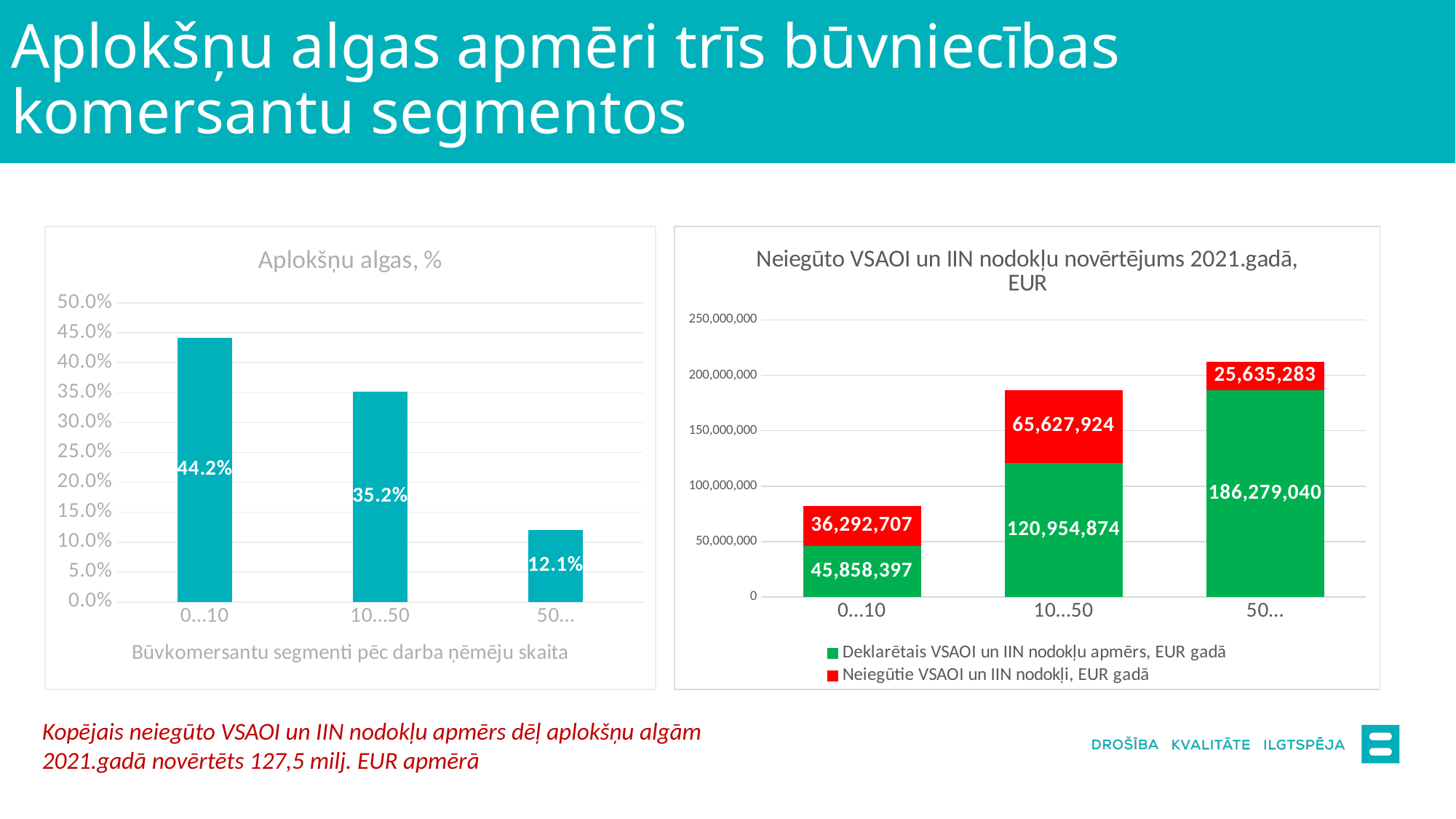
In the chart titled "Neiegūto VSAOI un IIN nodokļu novērtējums 2021.gadā, EUR", which segment has the highest value of "Neiegūtie VSAOI un IIN nodokļi, EUR gadā"? 10...50 In the chart titled "Neiegūto VSAOI un IIN nodokļu novērtējums 2021.gadā, EUR", how many series does the legend list? 2 In the chart titled "Aplokšņu algas, %", how many segments are plotted? 3 What kind of chart is the chart on the right of the slide? Stacked bar chart In the chart titled "Aplokšņu algas, %", what is the difference between the 0...10 and 10...50 segments? 9.0% In the chart titled "Neiegūto VSAOI un IIN nodokļu novērtējums 2021.gadā, EUR", what is the total of the stacked bar for the 0...10 segment? 82,151,104 In the chart titled "Aplokšņu algas, %", which segment has the lowest value? 50... In the chart titled "Aplokšņu algas, %", do the values rise or fall from left to right along the x axis? fall In the chart titled "Neiegūto VSAOI un IIN nodokļu novērtējums 2021.gadā, EUR", what is the value of "Neiegūtie VSAOI un IIN nodokļi, EUR gadā" for the 10...50 segment? 65,627,924 In the chart titled "Neiegūto VSAOI un IIN nodokļu novērtējums 2021.gadā, EUR", which is larger for the 0...10 segment: the declared amount (green) or the uncollected amount (red)? Declared amount (green), 45,858,397 In the chart titled "Aplokšņu algas, %", what is the value for the 0...10 segment? 44.2% In the chart titled "Neiegūto VSAOI un IIN nodokļu novērtējums 2021.gadā, EUR", what is the value of "Deklarētais VSAOI un IIN nodokļu apmērs, EUR gadā" for the 50... segment? 186,279,040